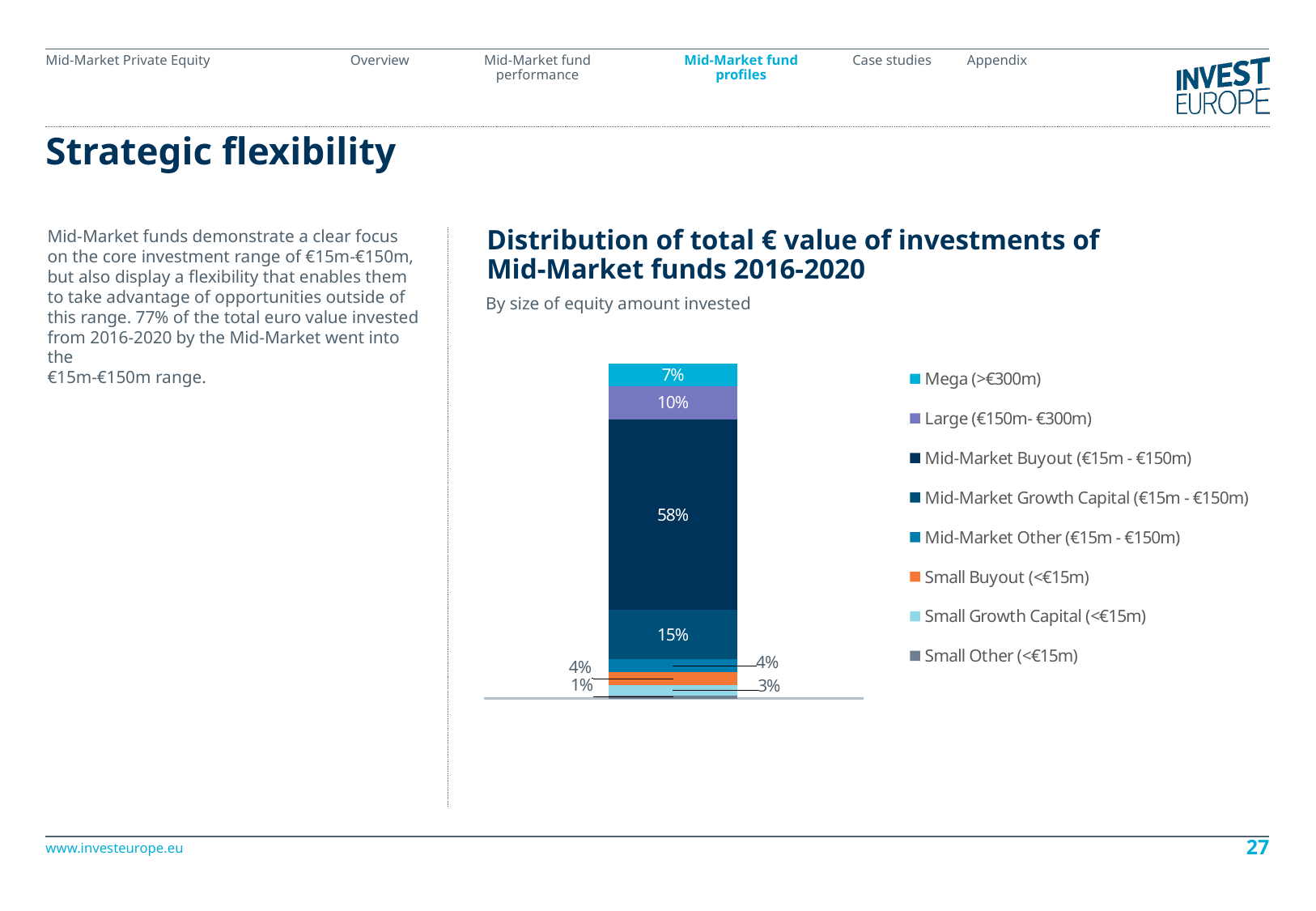
What percentage is shown for Small Buyout (<€15m)? 4% What percentage is shown for Large (€150m- €300m)? 10% Which category accounts for the largest share of the stacked bar? Mid-Market Buyout (€15m - €150m) What percentage of the total € value of investments is attributed to Mid-Market Buyout (€15m - €150m)? 58% Which has a larger share: Large (€150m- €300m) or Mega (>€300m)? Large (€150m- €300m) What share of the bar is labelled for Mega (>€300m)? 7% What is the difference in percentage points between Mid-Market Buyout (€15m - €150m) and Mid-Market Growth Capital (€15m - €150m)? 43 percentage points What type of chart is shown on the slide? Stacked bar chart What is the title of the chart? Distribution of total € value of investments of Mid-Market funds 2016-2020 How many categories does the legend list? 8 Which category accounts for the smallest share of the stacked bar? Small Other (<€15m) What percentage is shown for Mid-Market Growth Capital (€15m - €150m)? 15%